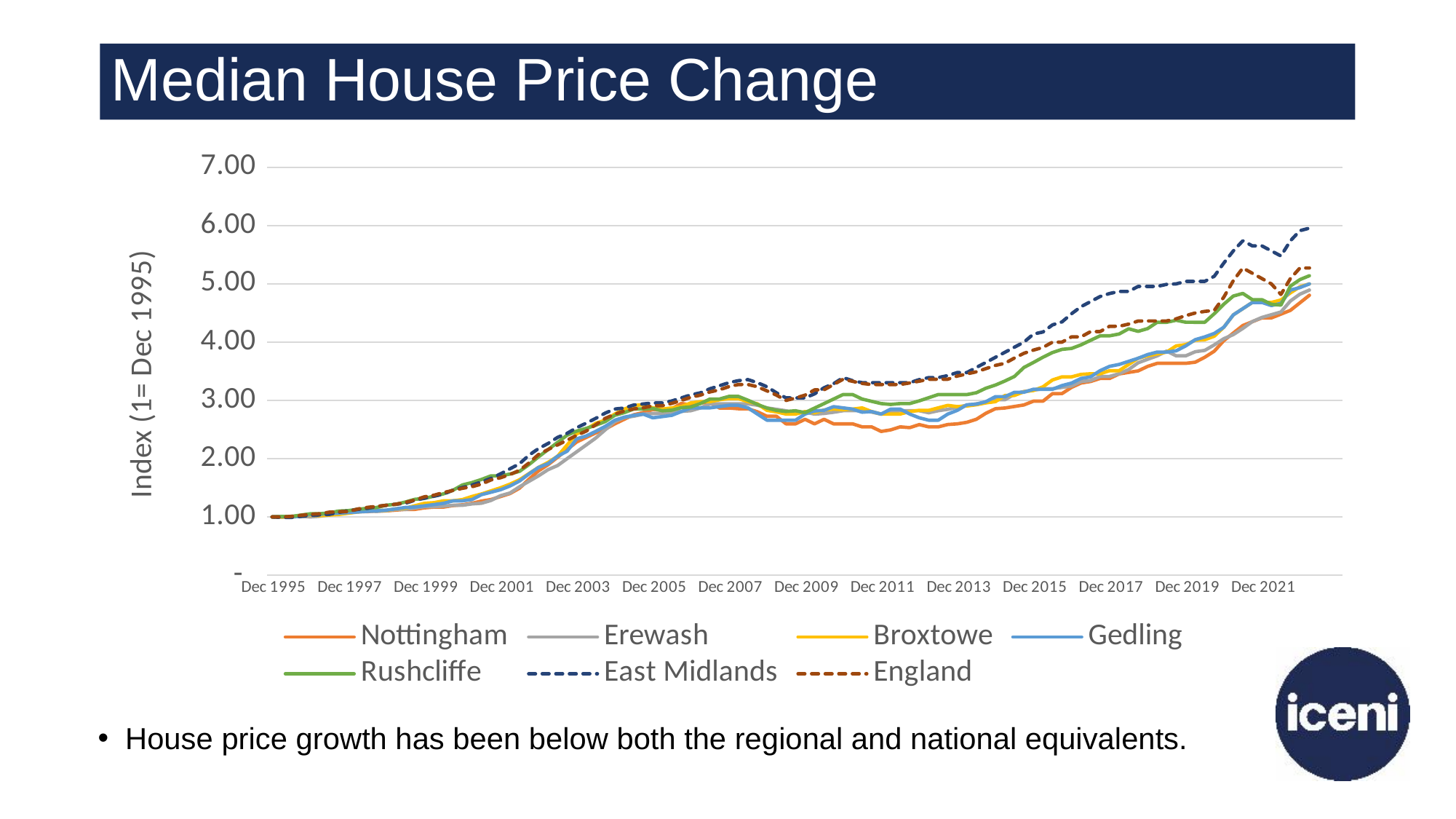
What is the index value for all series at Dec 1995? 1.00 Is the value for Rushcliffe at Dec 2009 greater or less than 2.00? greater Which two series are drawn with dashed lines? East Midlands and England Which series is lowest around Dec 2011? Nottingham What is the label on the vertical axis? Index (1= Dec 1995) At Dec 2021, which is larger: East Midlands or Nottingham? East Midlands Is the value for Nottingham at Dec 2021 greater or less than 5.00? less How many series does the legend list? 7 Which series is highest at the right-hand end of the chart? East Midlands What kind of chart is shown on the slide? line chart Do the index values generally rise or fall from Dec 1995 to the end of the chart? rise Is the value for East Midlands at Dec 2021 greater or less than 5.00? greater